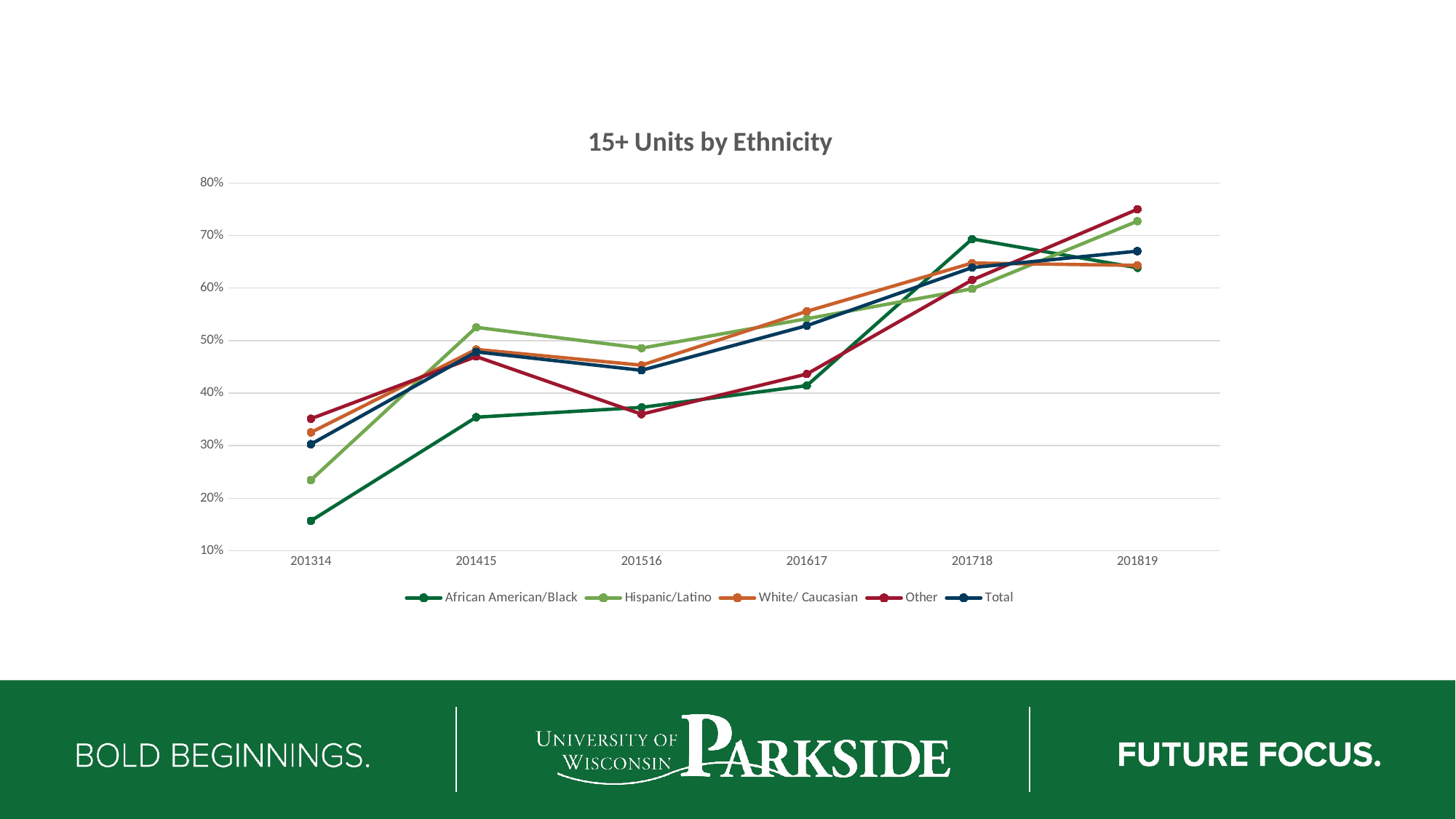
What kind of chart is shown on the slide? line chart What is the title of the chart? 15+ Units by Ethnicity Which series has the highest value in 201718? African American/Black How many academic years are shown on the x axis? 6 In 201415, which is larger: Hispanic/Latino or African American/Black? Hispanic/Latino Which series has the highest value in 201819? Other Does the Total series rise or fall overall from 201314 to 201819? rise Is the value for African American/Black in 201314 greater or less than 20%? less How many series does the legend list? 5 Is the value for Hispanic/Latino in 201819 greater or less than 70%? greater Which series has the lowest value in 201314? African American/Black Is the value for Other in 201516 greater or less than 40%? less